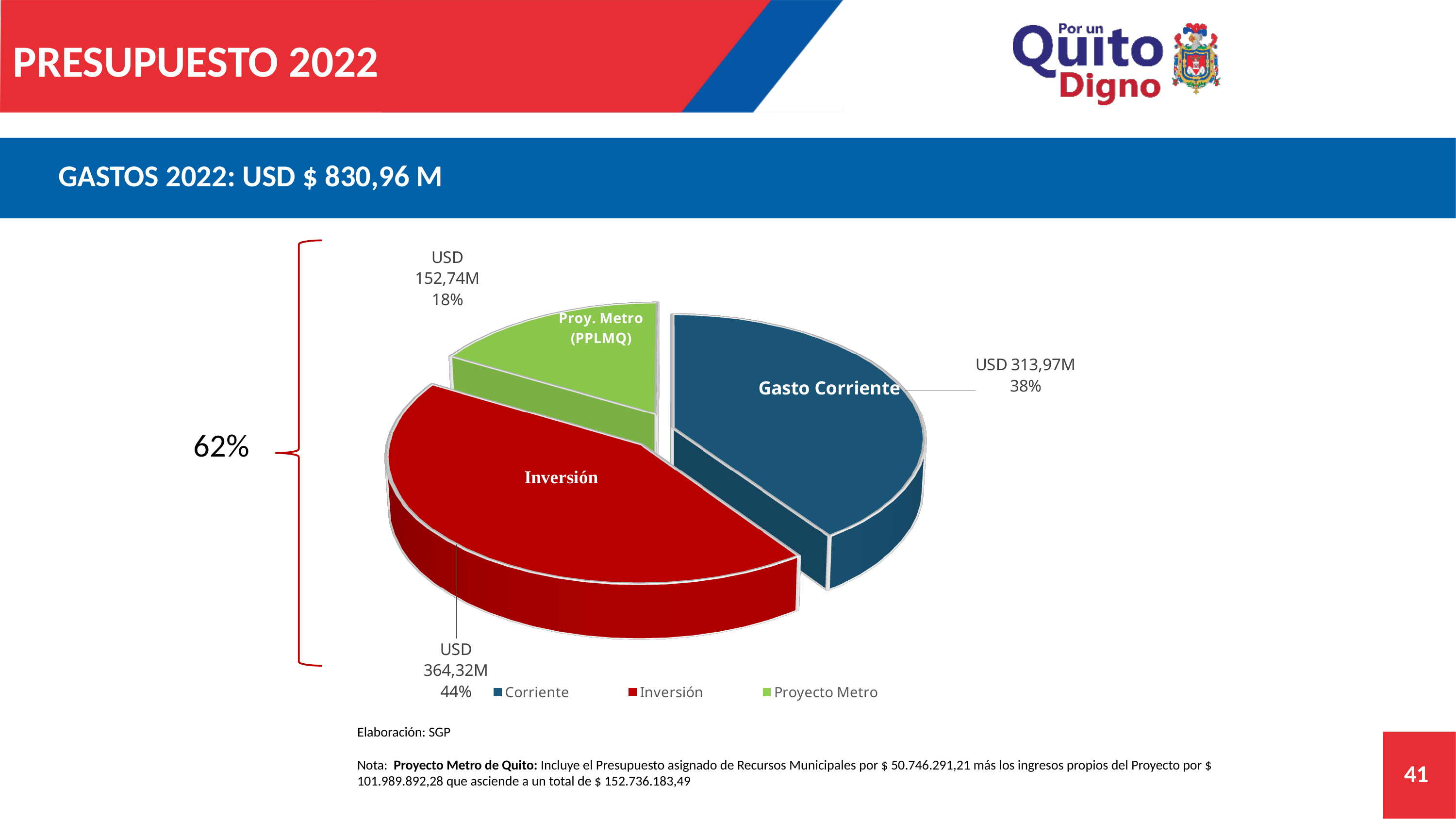
What share of the pie does Gasto Corriente represent? 38% Which slice is the largest? Inversión What is the value for Gasto Corriente? USD 313,97M What is the value for Inversión? USD 364,32M How many entries does the legend list? 3 What is the value for Proy. Metro (PPLMQ)? USD 152,74M What share of the pie does Proy. Metro (PPLMQ) represent? 18% Which slice is the smallest? Proy. Metro (PPLMQ) What share of the pie does Inversión represent? 44% How many slices does the pie chart have? 3 Which is larger, Gasto Corriente or Inversión? Inversión What kind of chart is shown on the slide? Pie chart